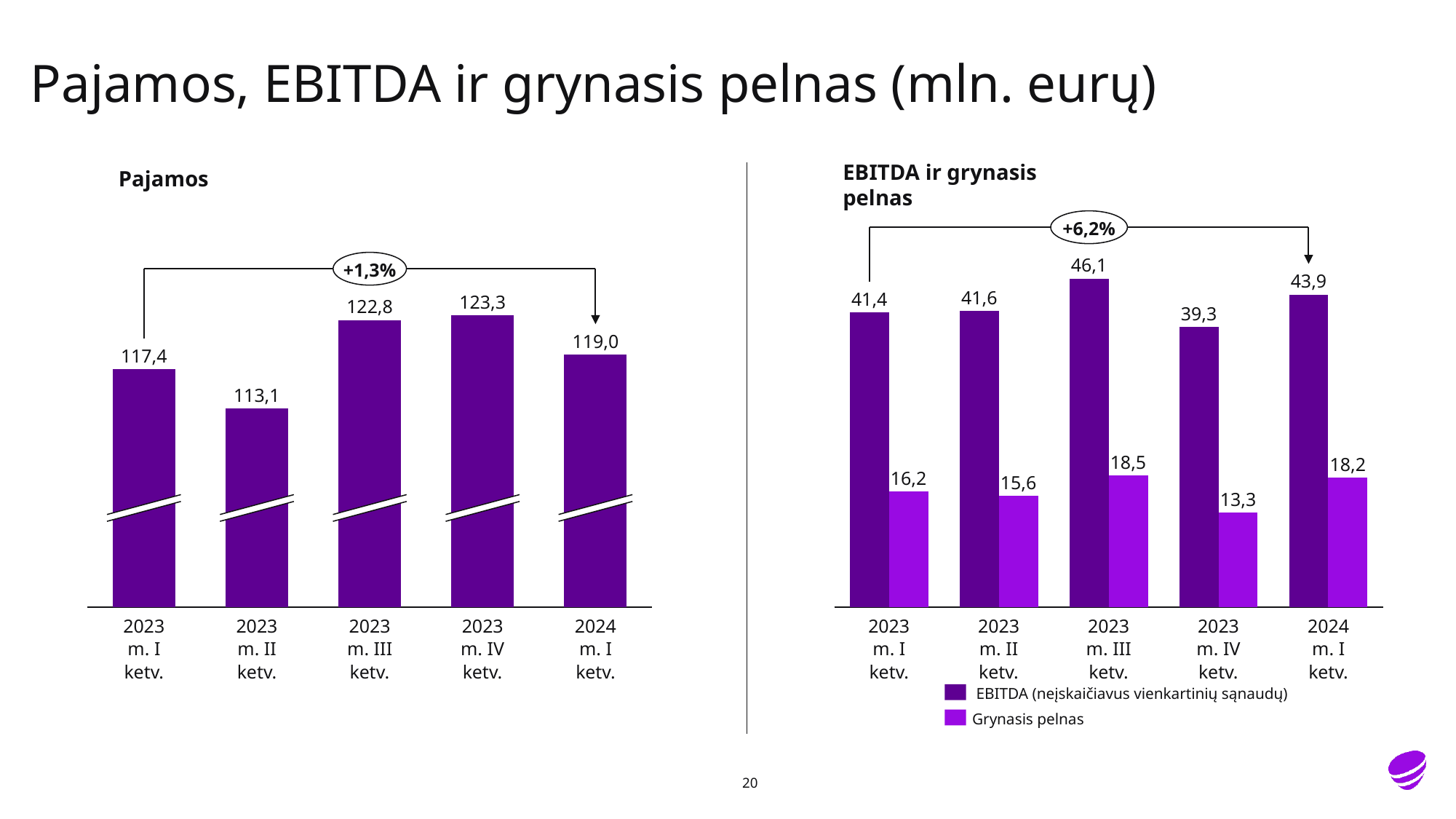
What kind of chart is the Pajamos chart? Bar chart In the Pajamos chart, what is the value for 2024 m. I ketv.? 119,0 In the Pajamos chart, what is the value for 2023 m. I ketv.? 117,4 In the EBITDA ir grynasis pelnas chart, how many series does the legend list? 2 In the Pajamos chart, which quarter has the highest value? 2023 m. IV ketv. In the Pajamos chart, how many quarters are shown? 5 In the Pajamos chart, what is the difference between the values for 2023 m. IV ketv. and 2023 m. II ketv.? 10,2 In the EBITDA ir grynasis pelnas chart, what is the difference between the Grynasis pelnas values for 2023 m. III ketv. and 2023 m. IV ketv.? 5,2 In the Pajamos chart, which quarter has the lowest value? 2023 m. II ketv. In the EBITDA ir grynasis pelnas chart, what is the Grynasis pelnas value for 2023 m. IV ketv.? 13,3 In the EBITDA ir grynasis pelnas chart, what is the EBITDA value for 2023 m. III ketv.? 46,1 In the EBITDA ir grynasis pelnas chart, which quarter has the lowest EBITDA value? 2023 m. IV ketv.